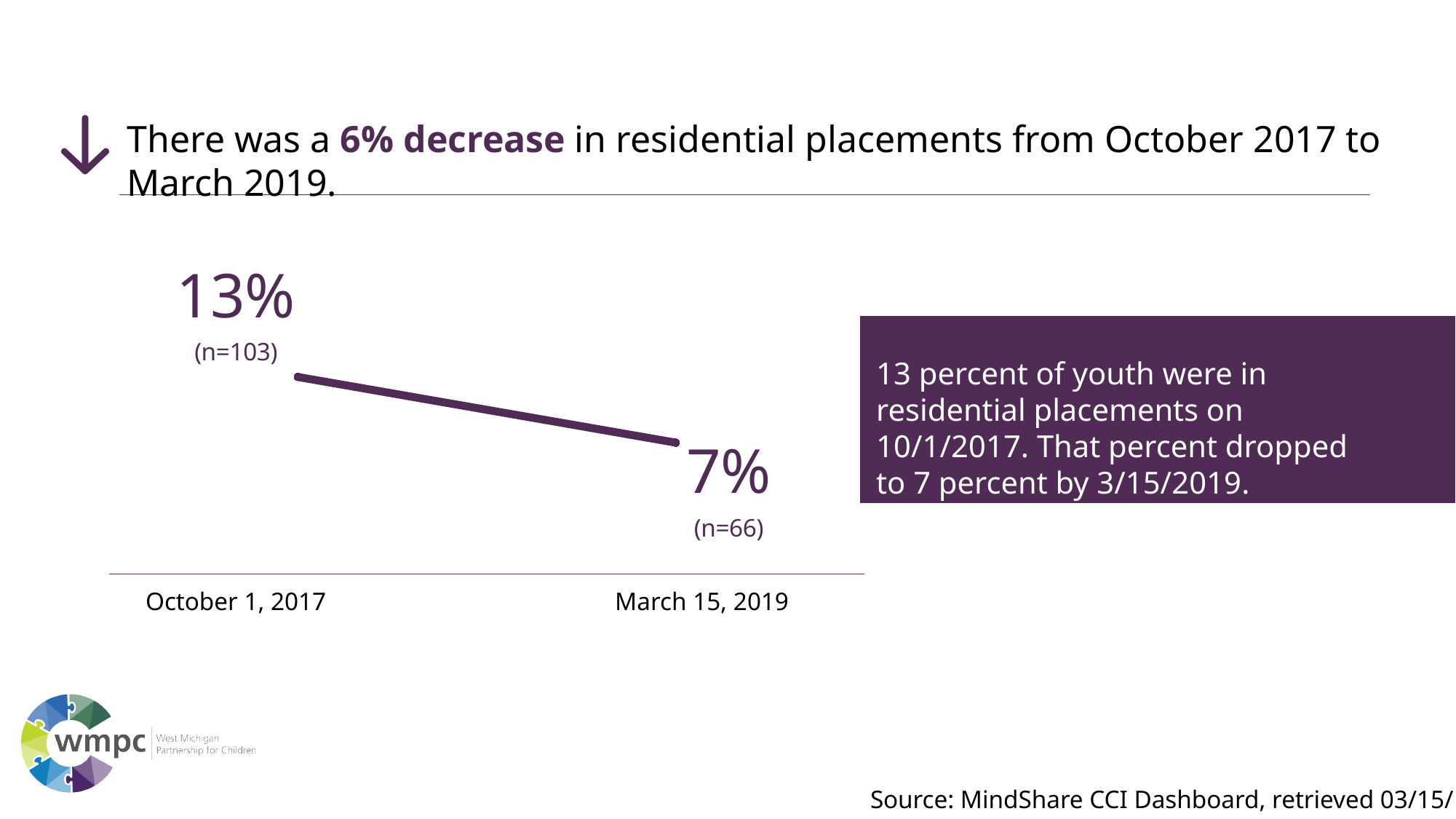
What is the n value shown for October 1, 2017? n=103 What percentage of youth were in residential placements on March 15, 2019? 7% Do the values rise or fall from October 1, 2017 to March 15, 2019? fall What kind of chart is shown on the slide? line chart Which date has the lower percentage of residential placements? March 15, 2019 What is the difference in percentage points between October 1, 2017 and March 15, 2019? 6% What percentage of youth were in residential placements on October 1, 2017? 13% How many data points are plotted on the chart? 2 Is the percentage for October 1, 2017 larger or smaller than the percentage for March 15, 2019? larger What is the n value shown for March 15, 2019? n=66 Which date has the higher percentage of residential placements? October 1, 2017 What is the difference in the number of youth (n) between October 1, 2017 and March 15, 2019? 37